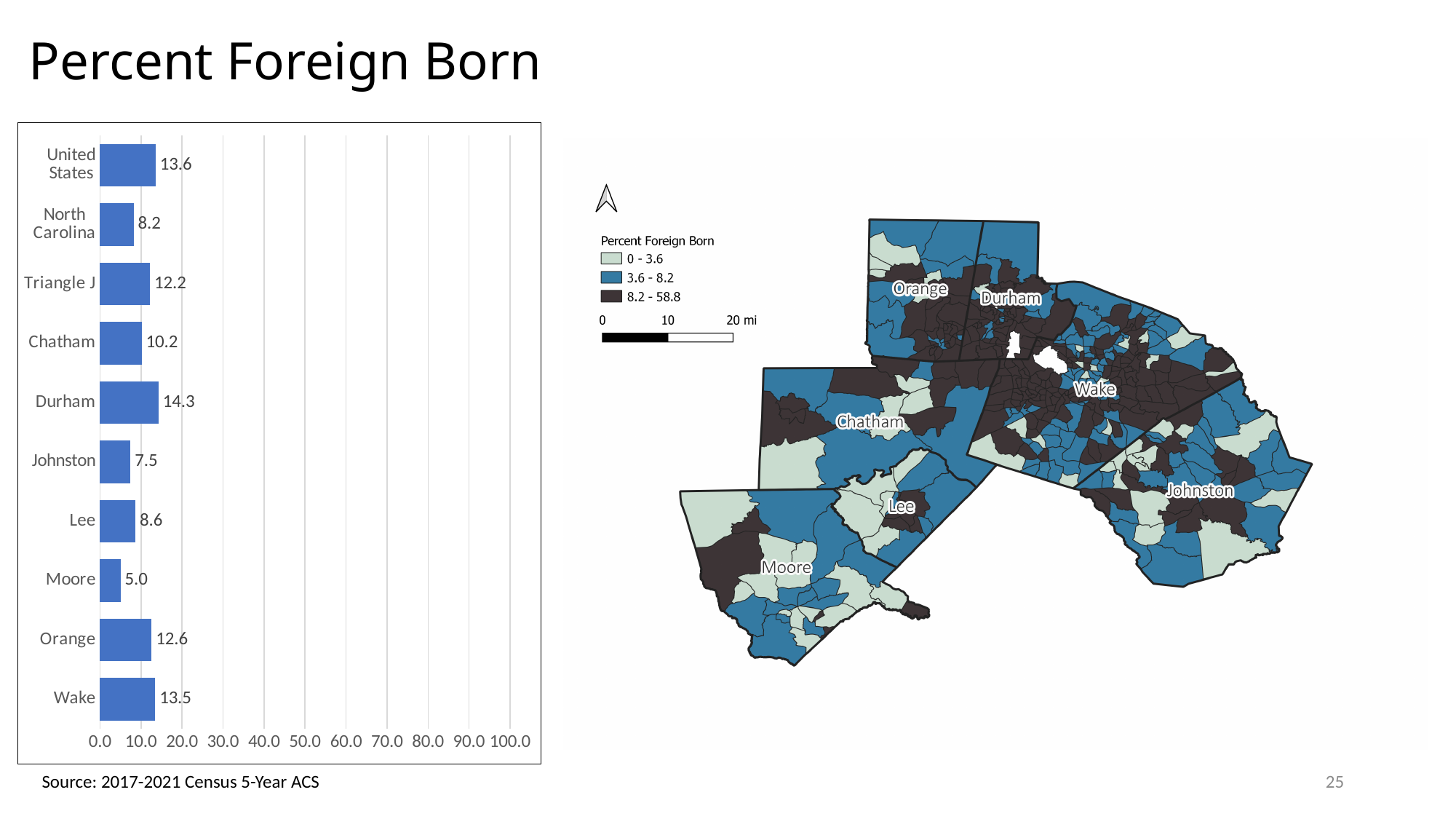
In the bar chart, is the value for Chatham greater or less than 20.0? less In the bar chart, what is the difference between the United States and North Carolina values? 5.4 In the bar chart, what is the difference between the values for Durham and Moore? 9.3 How many categories are shown in the bar chart? 10 In the bar chart, which has a higher percent foreign born, Wake or Johnston? Wake In the bar chart, which category has the lowest percent foreign born? Moore In the bar chart, which category has the highest percent foreign born? Durham What type of chart is shown on the left side of the slide? bar chart In the bar chart, what is the percent foreign born for Durham? 14.3 In the bar chart, what is the percent foreign born for North Carolina? 8.2 How many classes does the map legend for Percent Foreign Born list? 3 In the bar chart, what is the value shown for Moore? 5.0